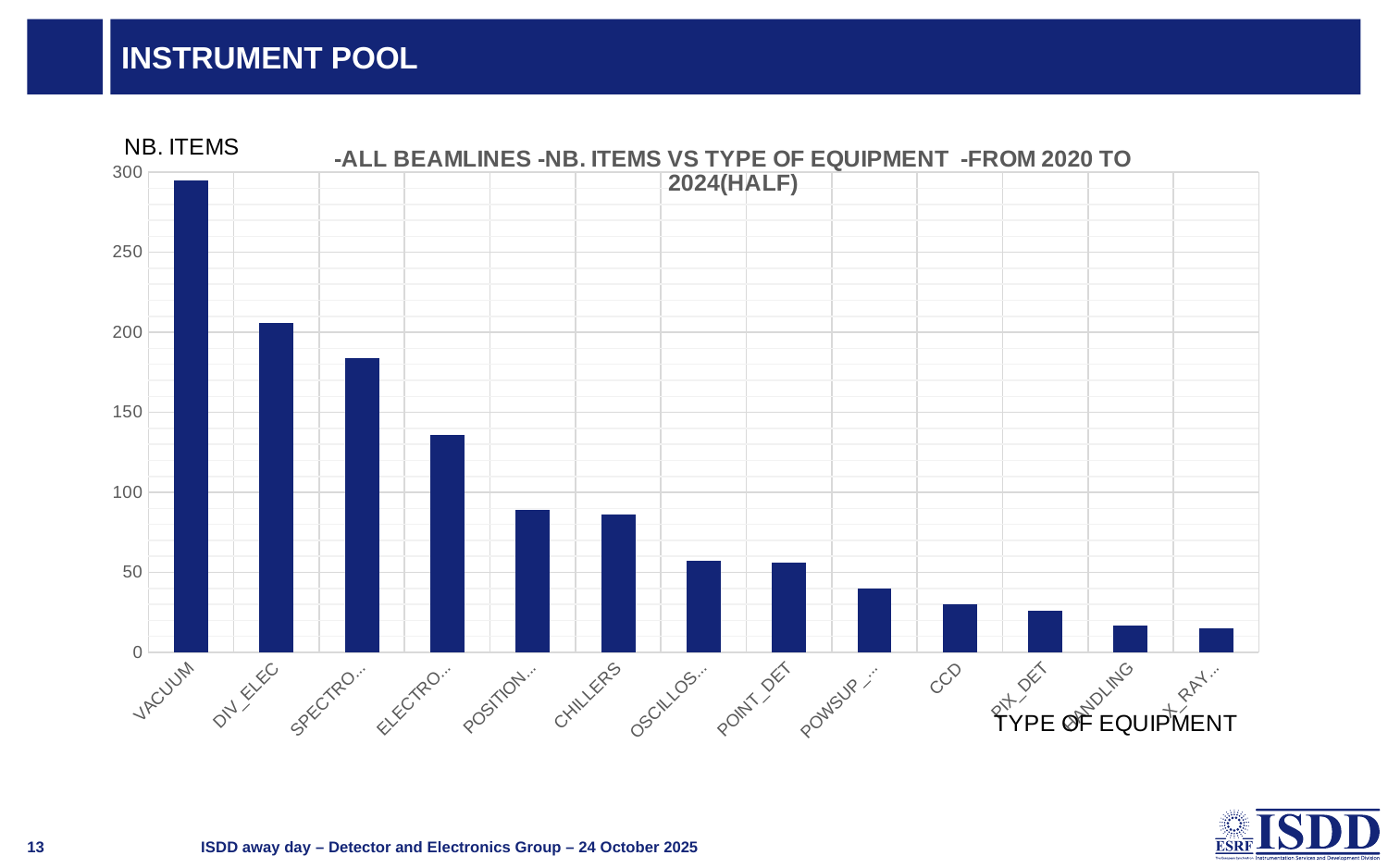
Do the values rise or fall from left to right along the x axis? fall Is the value for VACUUM greater or less than 250? greater Is the value for DIV_ELEC greater or less than 150? greater What kind of chart is shown on the slide? bar chart Is the value for PIX_DET greater or less than 50? less How many types of equipment are plotted on the chart? 13 What is the label of the vertical axis of the chart? NB. ITEMS Which type of equipment has the highest number of items? VACUUM Which has more items, CHILLERS or CCD? CHILLERS Which has more items, VACUUM or DIV_ELEC? VACUUM